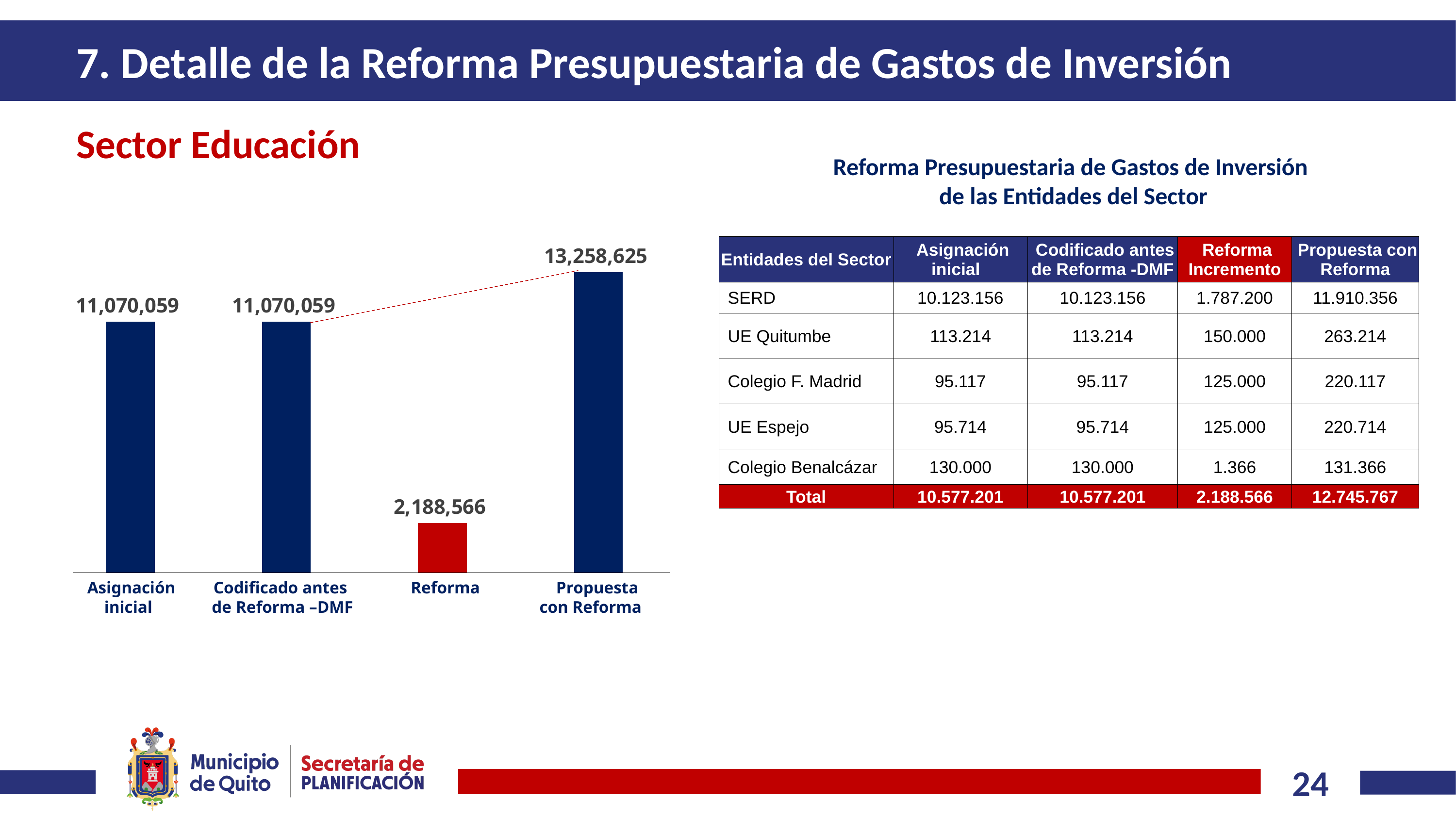
Which category has the lowest value in the bar chart? Reforma What is the value of the Propuesta con Reforma bar? 13,258,625 What colour is the Reforma bar? Red What is the value shown for Codificado antes de Reforma –DMF? 11,070,059 Which category has the highest value in the bar chart? Propuesta con Reforma What kind of chart is shown on the slide? Bar chart Which is larger, Propuesta con Reforma or Asignación inicial? Propuesta con Reforma What is the difference between Asignación inicial and Reforma? 8,881,493 How many categories are shown in the bar chart? 4 What is the difference between Propuesta con Reforma and Codificado antes de Reforma –DMF? 2,188,566 What is the value of the Asignación inicial bar? 11,070,059 What is the value shown for Reforma? 2,188,566